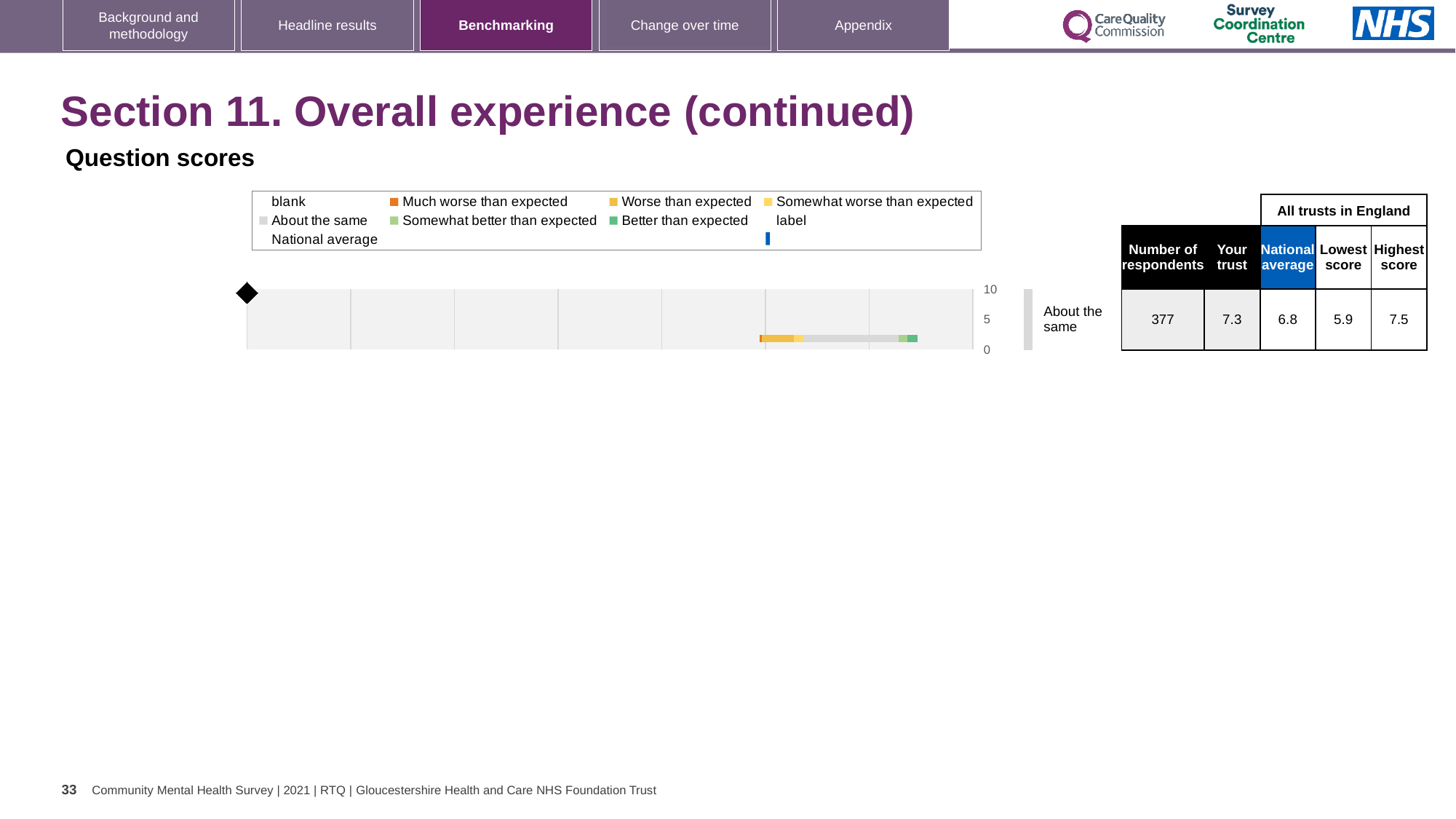
What is the difference between the 'Your trust' score and the National average score? 0.5 How many question categories are plotted in the chart? 1 What is the label of the single category plotted in the chart? About the same In the table beside the chart, what is the National average score? 6.8 In the table beside the chart, what is the Lowest score among all trusts in England? 5.9 What is the difference between the Highest score and the Lowest score in the table? 1.6 What is the highest value shown on the chart's numeric axis? 10 In the table beside the chart, how many respondents are listed? 377 In the table beside the chart, what is the Highest score among all trusts in England? 7.5 Which is larger, the 'Your trust' score or the National average score? Your trust In the table beside the chart, what is the 'Your trust' score for 'About the same'? 7.3 What kind of chart is shown under 'Question scores'? bar chart